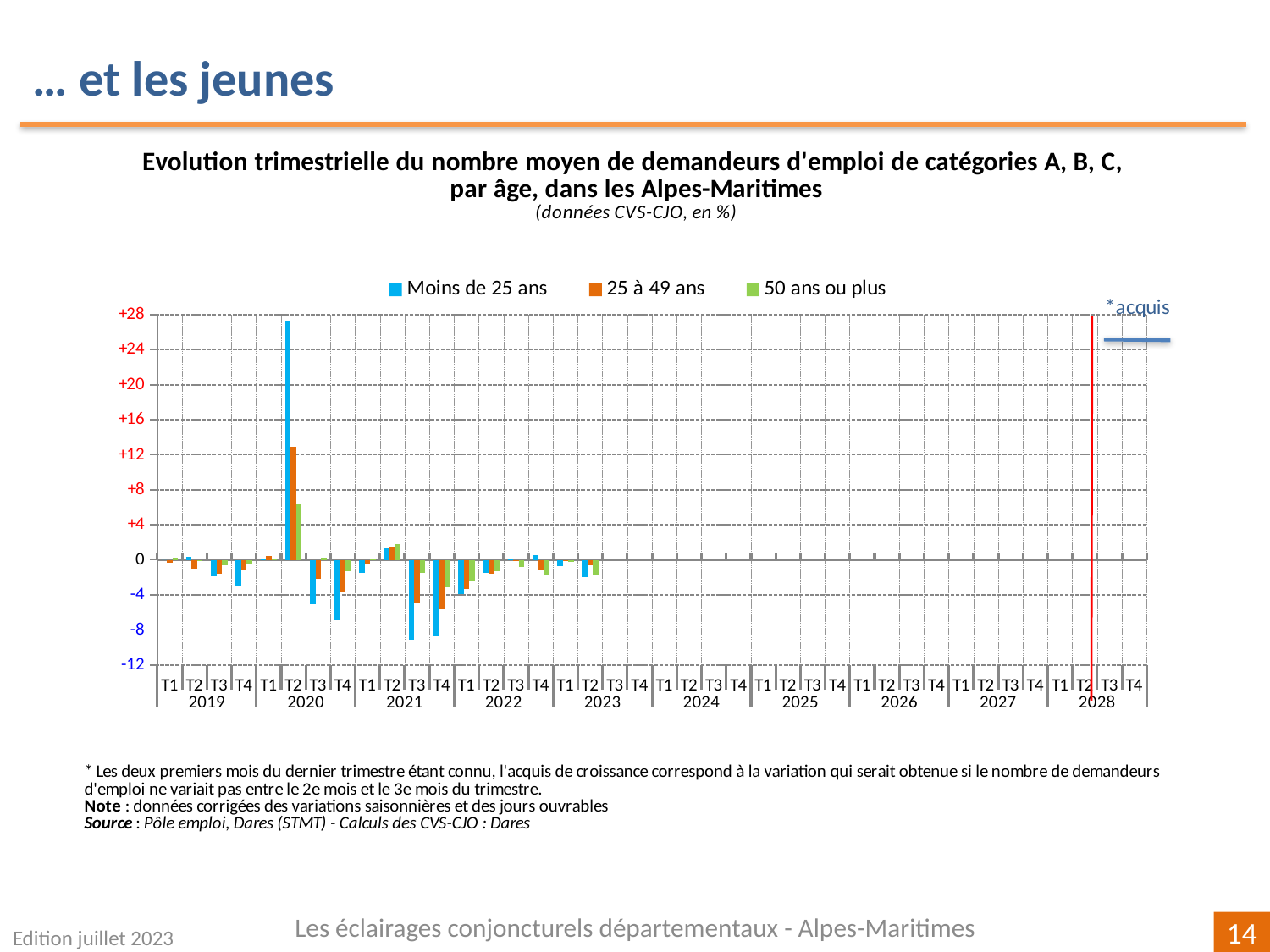
Is the value for 'Moins de 25 ans' in T4 2020 greater or less than -4? less Does the 'Moins de 25 ans' series rise or fall from T2 2020 to T4 2020? fall How many years are labelled along the x axis? 10 What label appears next to the red vertical line at the right of the chart? *acquis How many series does the legend list? 3 What kind of chart is shown on the slide? bar chart Is the value for '25 à 49 ans' in T2 2020 greater or less than +8? greater What are the three series named in the legend? Moins de 25 ans, 25 à 49 ans, 50 ans ou plus In T2 2020, which series has the larger value: 'Moins de 25 ans' or '50 ans ou plus'? Moins de 25 ans Is the value for '50 ans ou plus' in T2 2020 greater or less than +4? greater In which quarter does the 'Moins de 25 ans' series reach its highest value? T2 2020